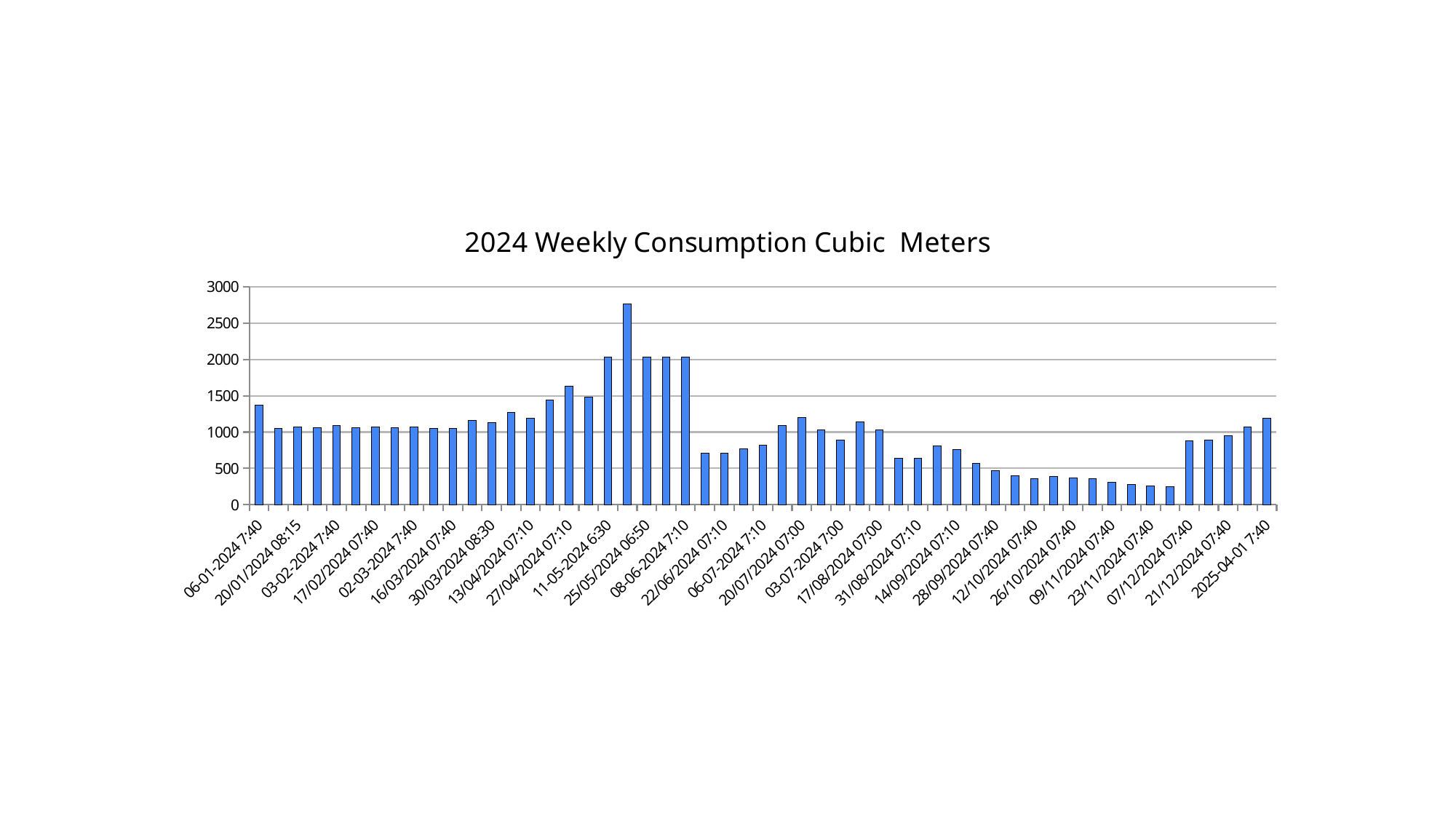
Which is larger, the value for 25/05/2024 06:50 or the value for 22/06/2024 07:10? 25/05/2024 06:50 What is the title of the chart? 2024 Weekly Consumption Cubic Meters Is the value for 25/05/2024 06:50 greater or less than 1500? greater Is the value for 06-01-2024 7:40 greater or less than 1000? greater Is the value for 12/10/2024 07:40 greater or less than 500? less What kind of chart is shown on the slide? bar chart Which is larger, the value for 06-01-2024 7:40 or the value for 20/01/2024 08:15? 06-01-2024 7:40 What is the highest value shown on the vertical axis? 3000 Do the values generally rise or fall from 28/09/2024 07:40 to 23/11/2024 07:40? fall